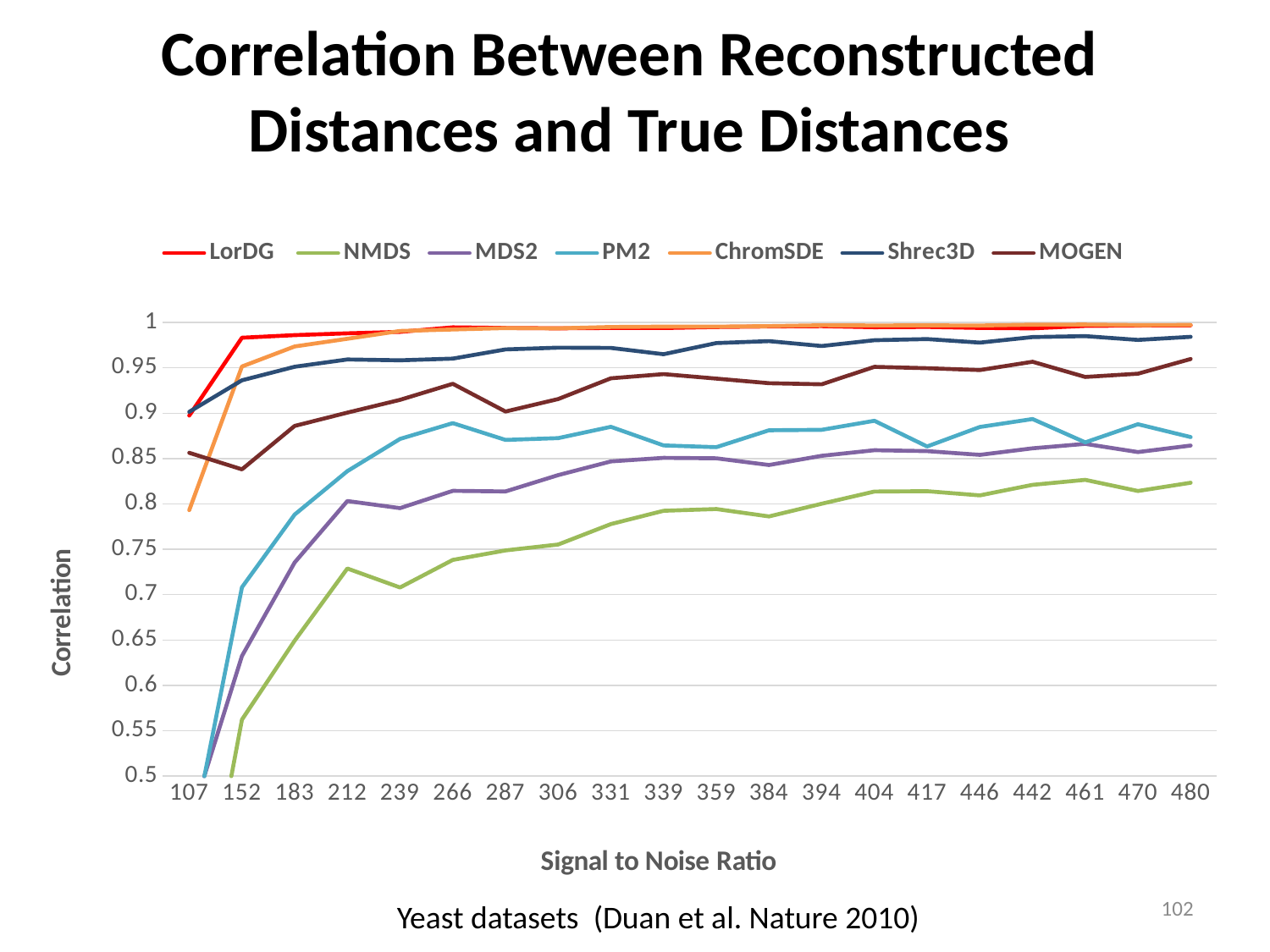
Does the correlation for NMDS generally rise or fall as the signal to noise ratio increases? rise Which series has the lowest correlation at a signal to noise ratio of 480? NMDS What kind of chart is shown on the slide? line chart How many series does the legend list? 7 At a signal to noise ratio of 480, which series has the higher correlation, MOGEN or PM2? MOGEN Which series has the highest correlation at a signal to noise ratio of 152? LorDG How many signal-to-noise ratio values are shown along the x axis? 20 What is the label of the x axis? Signal to Noise Ratio Is the correlation for NMDS at a signal to noise ratio of 212 greater or less than 0.7? greater Is the correlation for ChromSDE at a signal to noise ratio of 107 greater or less than 0.85? less Is the correlation for PM2 at a signal to noise ratio of 183 greater or less than 0.8? less What is the label of the y axis? Correlation